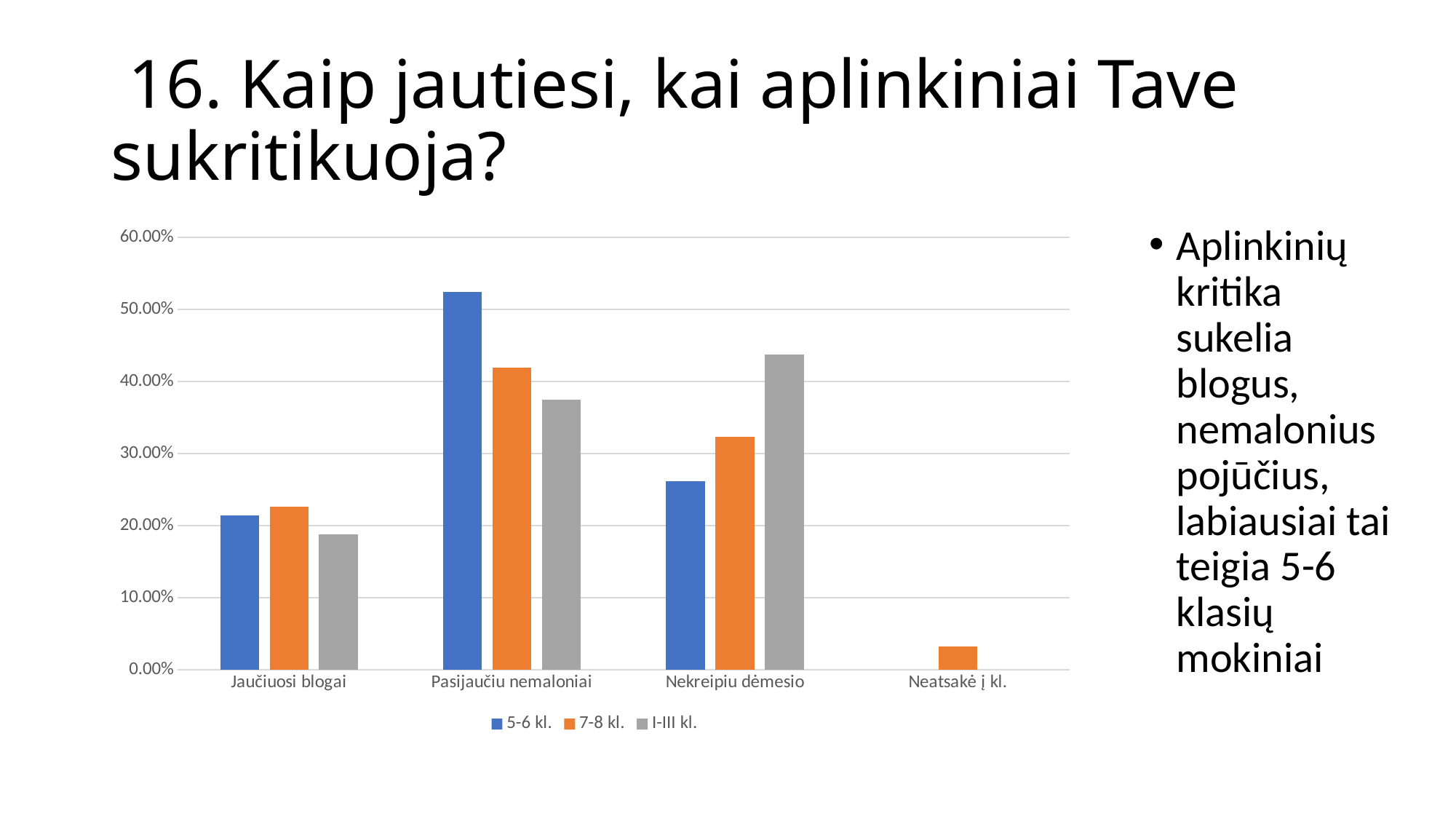
Which category has the highest value for the I-III kl. series? Nekreipiu dėmesio In the Pasijaučiu nemaloniai category, which series has the larger value: 5-6 kl. or 7-8 kl.? 5-6 kl. What are the three series listed in the legend? 5-6 kl., 7-8 kl., I-III kl. Is the value for I-III kl. in the Jaučiuosi blogai category greater or less than 20.00%? less Is the value for 7-8 kl. in the Nekreipiu dėmesio category greater or less than 30.00%? greater How many categories are shown on the x axis? 4 In the Nekreipiu dėmesio category, which series has the larger value: 5-6 kl. or I-III kl.? I-III kl. What kind of chart is shown on the slide? bar chart How many series does the legend list? 3 Which category has the highest value for the 5-6 kl. series? Pasijaučiu nemaloniai Is the value for 5-6 kl. in the Pasijaučiu nemaloniai category greater or less than 50.00%? greater